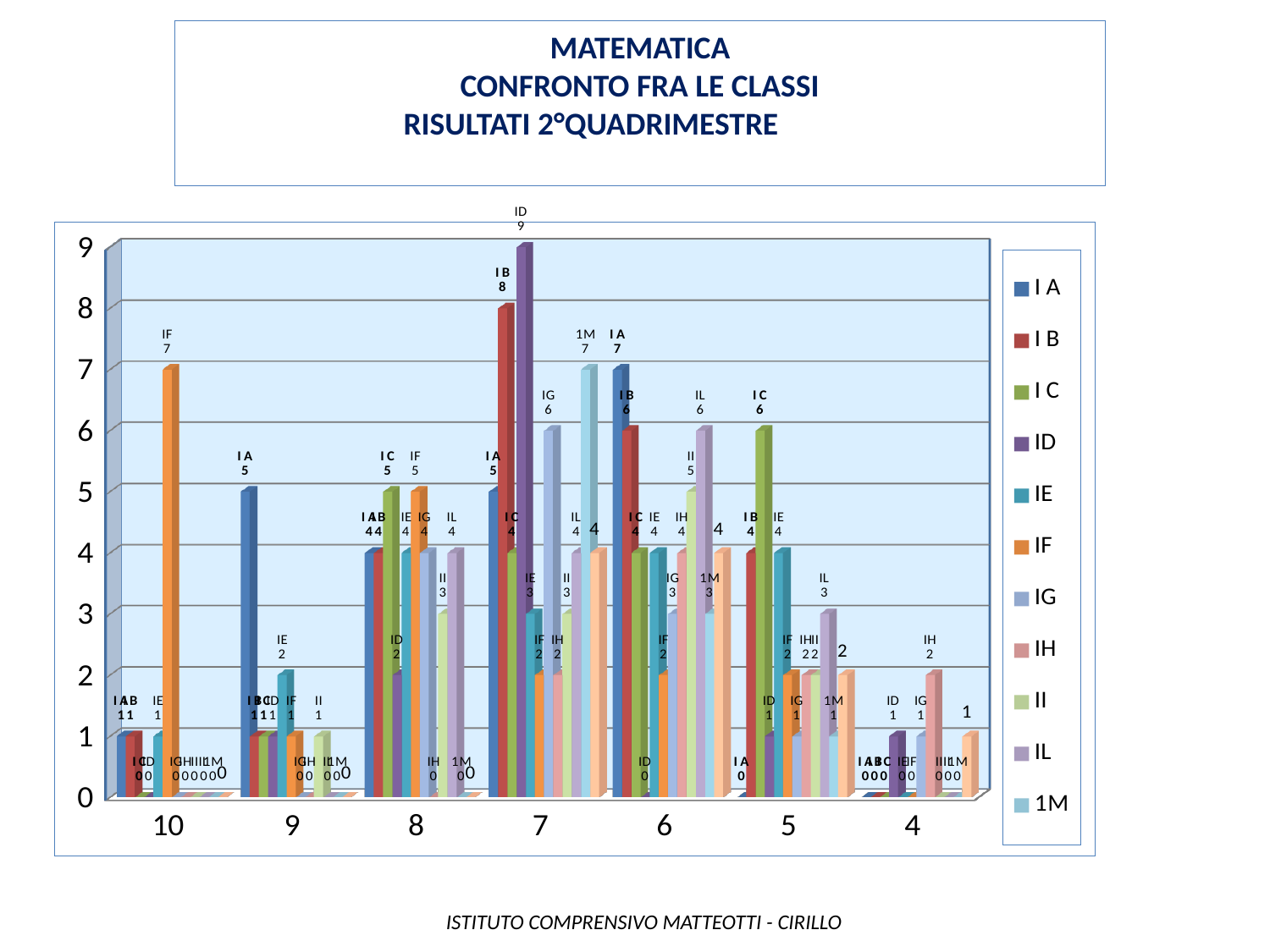
What is the difference between the values of I B and I A at grade 7? 3 Which class has the highest value at grade 10? IF What is the value for class IF at grade 10? 7 What kind of chart is shown on the slide? Bar chart What is the value for class I C at grade 5? 6 At grade 6, which is larger: the value for I A or the value for I B? I A How many grade categories are shown on the x axis? 7 What is the value for class 1M at grade 7? 7 Which class has the highest value at grade 7? ID How many series does the legend list? 11 What subject is named in the slide title? MATEMATICA What is the value for class ID at grade 7? 9